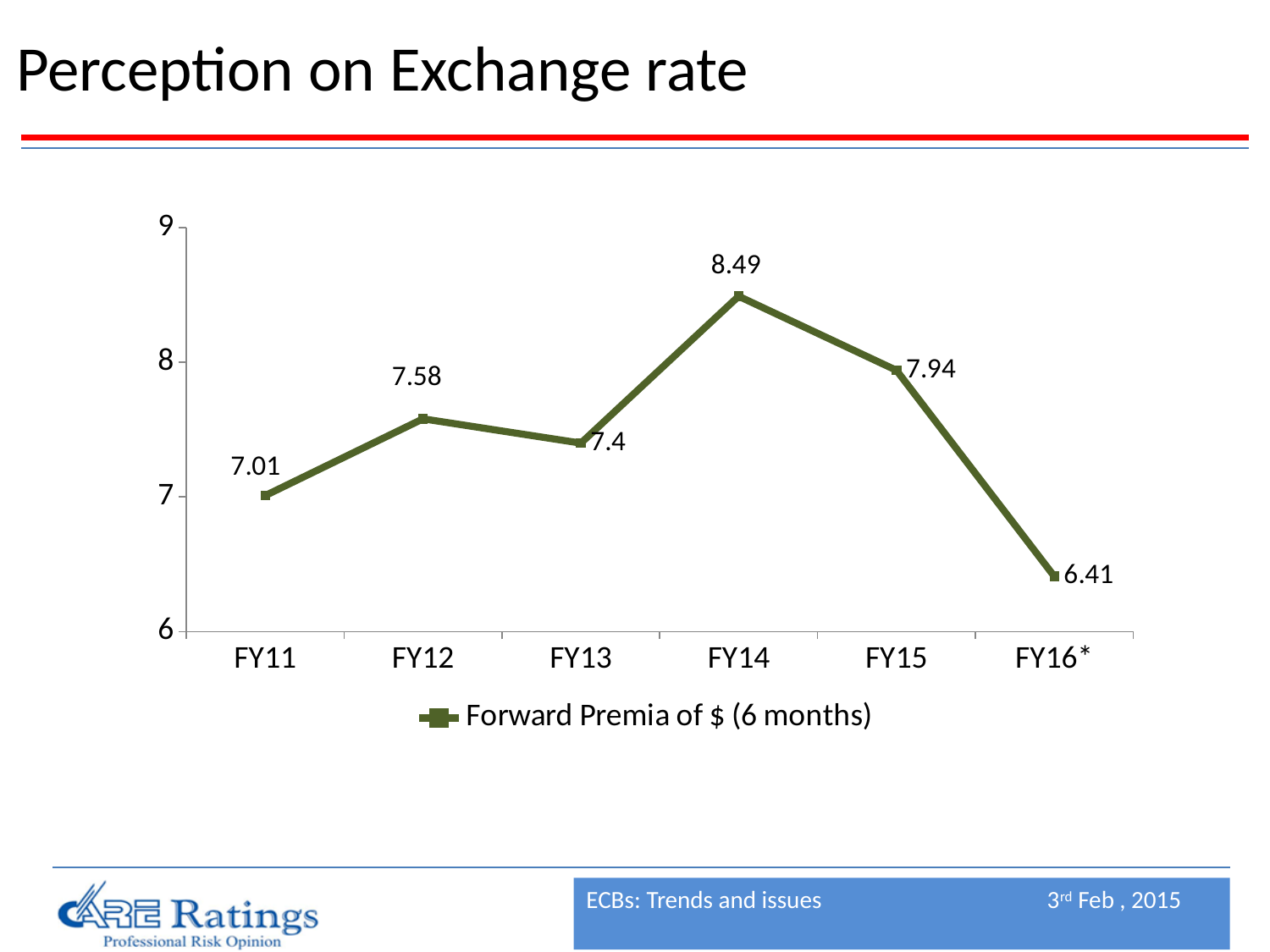
Does the Forward Premia rise or fall from FY14 to FY16*? fall Which fiscal year has the lowest Forward Premia of $ (6 months)? FY16* How many series does the legend list? 1 Is the Forward Premia value for FY15 greater or less than 8? less How many fiscal years are plotted on the chart? 6 What is the Forward Premia of $ (6 months) for FY16*? 6.41 What is the difference between the Forward Premia values for FY14 and FY15? 0.55 Which fiscal year has the highest Forward Premia of $ (6 months)? FY14 What is the Forward Premia of $ (6 months) for FY14? 8.49 What kind of chart is shown on the slide? line chart What is the Forward Premia of $ (6 months) for FY11? 7.01 Which is larger, the Forward Premia for FY12 or for FY13? FY12